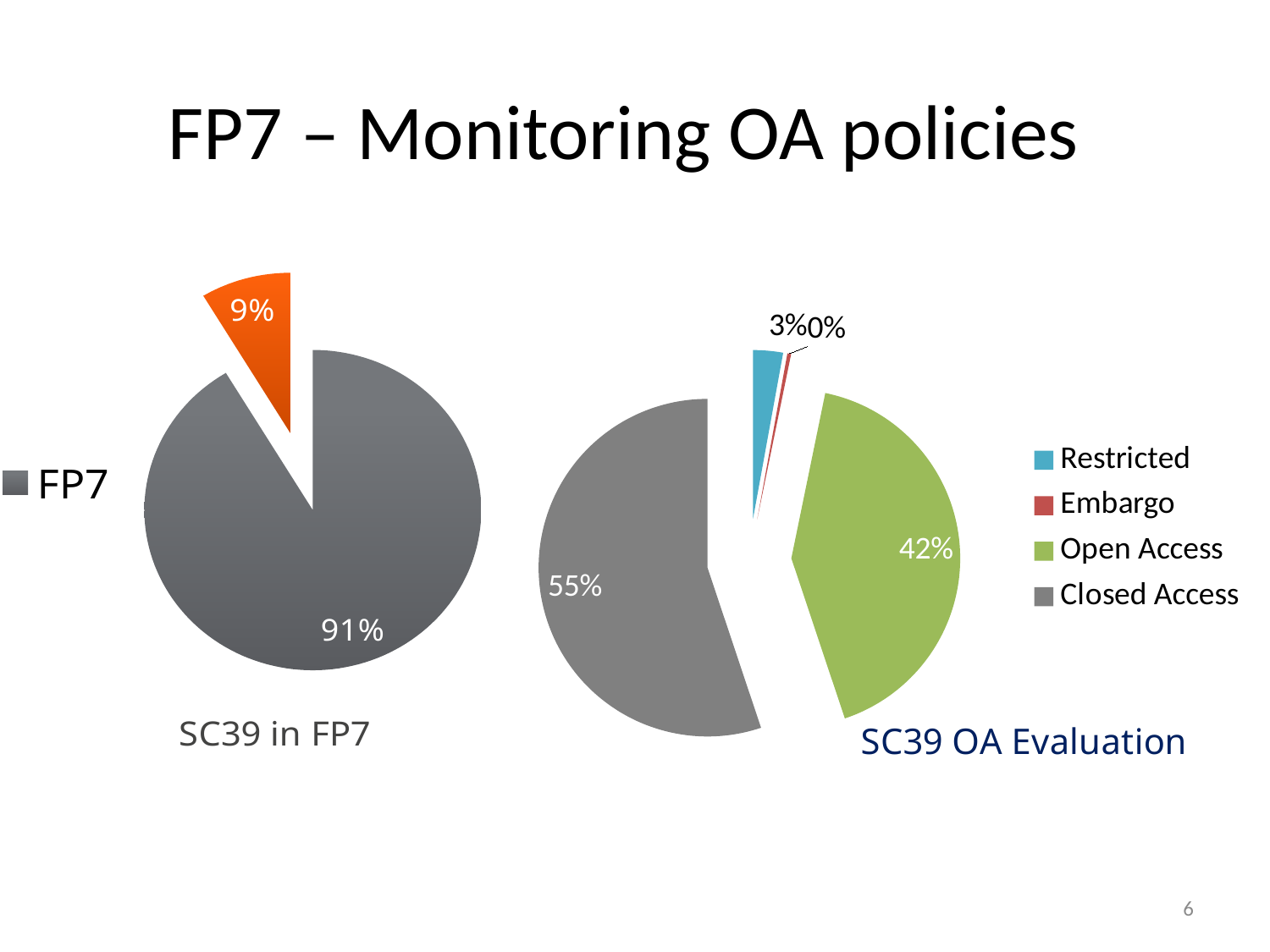
How many entries does the legend of the 'SC39 OA Evaluation' chart list? 4 In the 'SC39 OA Evaluation' pie chart, what share is labelled for Closed Access? 55% In the 'SC39 OA Evaluation' pie chart, what share is labelled for Open Access? 42% In the 'SC39 OA Evaluation' pie chart, what share is labelled for Restricted? 3% In the 'SC39 in FP7' chart, what share is labelled on the orange slice? 9% In the 'SC39 OA Evaluation' pie chart, what is the difference between the Closed Access and Open Access shares? 13% What type of chart is 'SC39 in FP7'? Pie chart In the 'SC39 in FP7' chart, what share is labelled on the grey FP7 slice? 91% In the 'SC39 OA Evaluation' pie chart, which category has the largest share? Closed Access In the 'SC39 OA Evaluation' pie chart, what share is labelled for Embargo? 0% In the 'SC39 OA Evaluation' pie chart, which category has the smallest share? Embargo In the 'SC39 OA Evaluation' pie chart, which is larger, Restricted or Open Access? Open Access